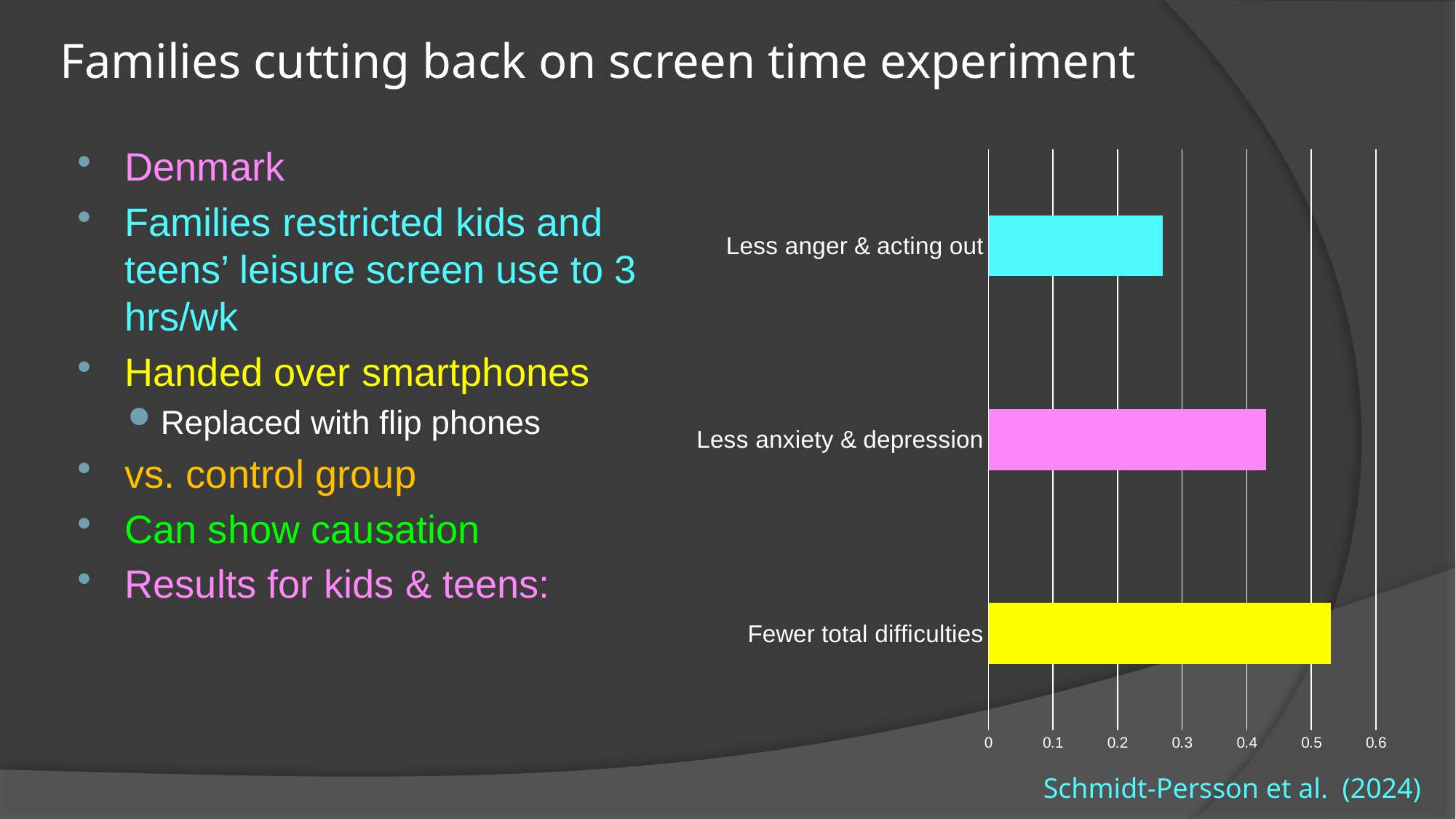
Is the value for Less anger & acting out greater or less than 0.2? greater Is the value for Less anxiety & depression greater or less than 0.4? greater How many categories are plotted in the chart? 3 What colour is the bar for Fewer total difficulties? yellow What kind of chart is shown on the slide? bar chart What is the highest value shown on the chart's horizontal axis? 0.6 Which is larger, the value for Less anxiety & depression or the value for Less anger & acting out? Less anxiety & depression Which is larger, the value for Fewer total difficulties or the value for Less anxiety & depression? Fewer total difficulties Is the value for Fewer total difficulties greater or less than 0.5? greater Which category has the longest bar in the chart? Fewer total difficulties Which category has the shortest bar in the chart? Less anger & acting out